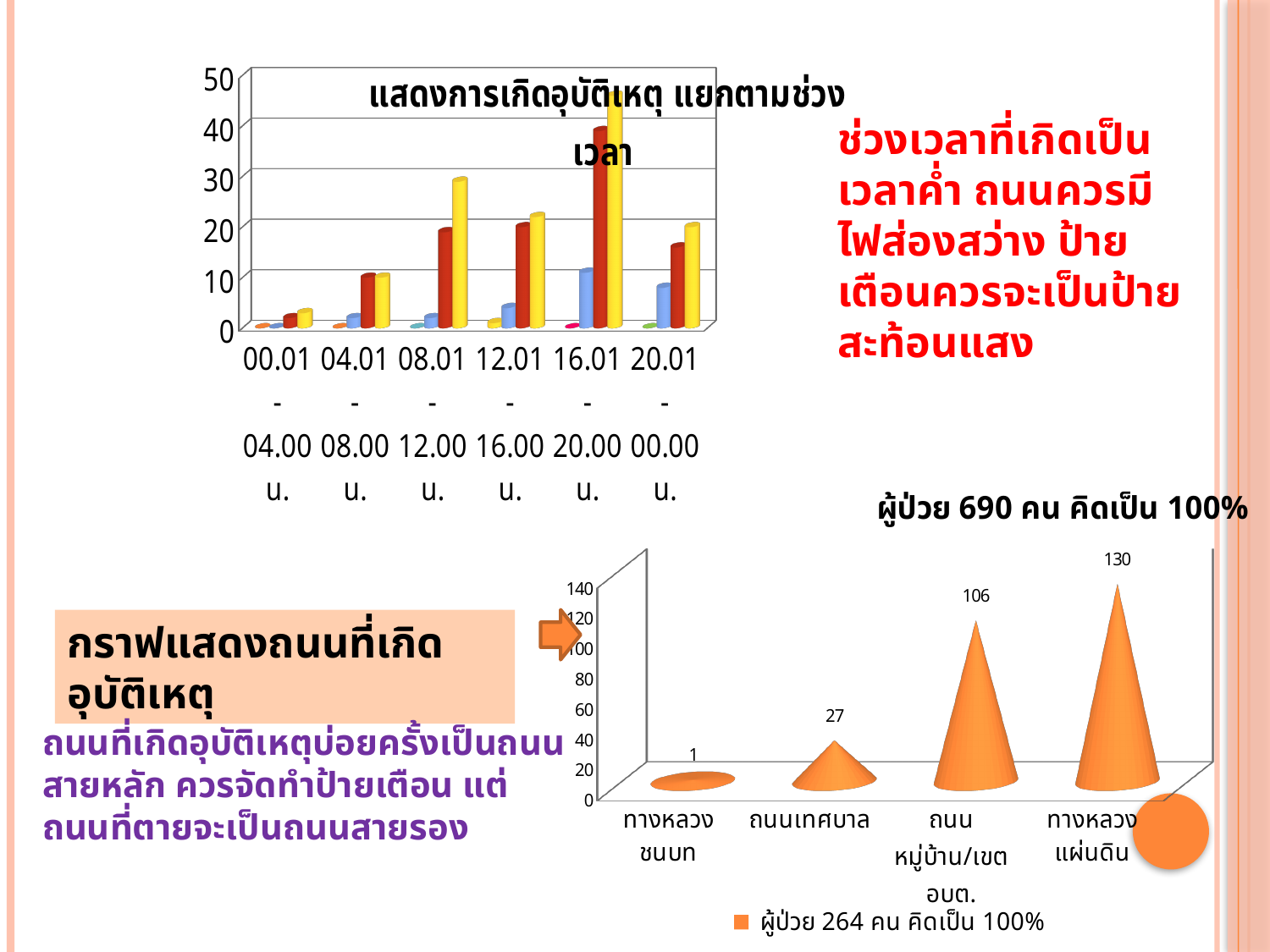
In the bottom chart, which road category has the lowest value? ทางหลวงชนบท In the bottom chart, what is the value for ถนนเทศบาล? 27 In the bottom chart, what is the difference between the values for ทางหลวงแผ่นดิน and ถนนหมู่บ้าน/เขต อบต.? 24 In the bottom chart, what is the value for ถนนหมู่บ้าน/เขต อบต.? 106 In the top chart (แสดงการเกิดอุบัติเหตุ แยกตามช่วงเวลา), is the tallest yellow bar, for 16.01-20.00 น., greater or less than 40? greater In the bottom chart, which road category has the highest value? ทางหลวงแผ่นดิน How many time-period categories are shown on the x axis of the top chart? 6 In the bottom chart, do the values rise or fall from left to right along the x axis? rise In the bottom chart (ถนนที่เกิดอุบัติเหตุ), what is the value for ทางหลวงแผ่นดิน? 130 How many road categories are shown in the bottom chart? 4 What is the legend entry of the bottom chart? ผู้ป่วย 264 คน คิดเป็น 100% In the bottom chart, which is larger: the value for ถนนเทศบาล or the value for ทางหลวงชนบท? ถนนเทศบาล